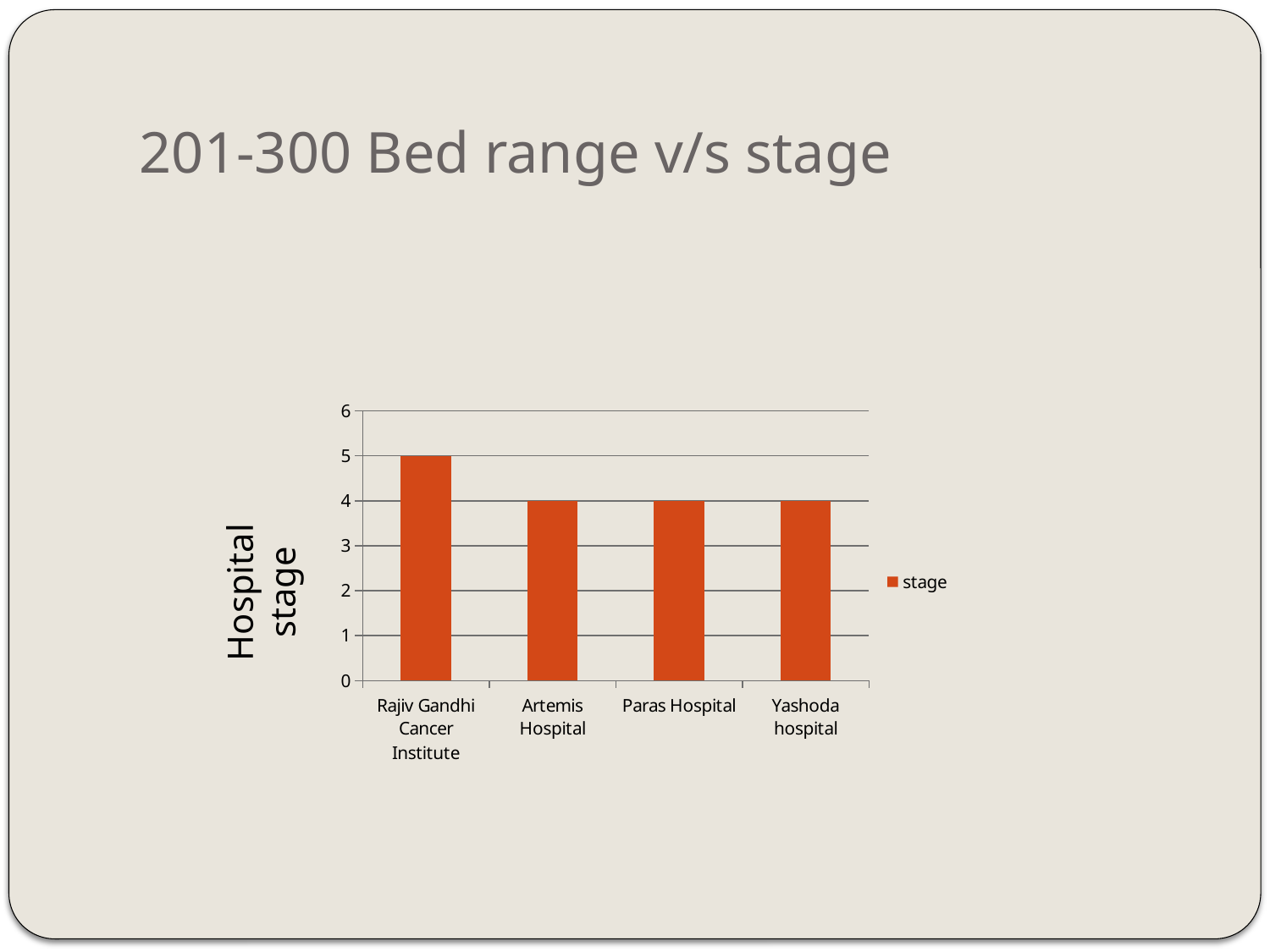
What type of chart is shown on the slide? bar chart What is the title of the slide containing the chart? 201-300 Bed range v/s stage What is the stage value for Yashoda hospital? 4 How many series does the chart legend list? 1 How many hospitals are shown on the x axis of the chart? 4 What is the stage value for Artemis Hospital? 4 What is the difference between the stage values of Rajiv Gandhi Cancer Institute and Artemis Hospital? 1 What is the stage value for Rajiv Gandhi Cancer Institute? 5 What is the stage value for Paras Hospital? 4 Which hospital has the highest stage value? Rajiv Gandhi Cancer Institute Is the stage value for Yashoda hospital greater or less than 5? less Which has a larger stage value, Rajiv Gandhi Cancer Institute or Paras Hospital? Rajiv Gandhi Cancer Institute